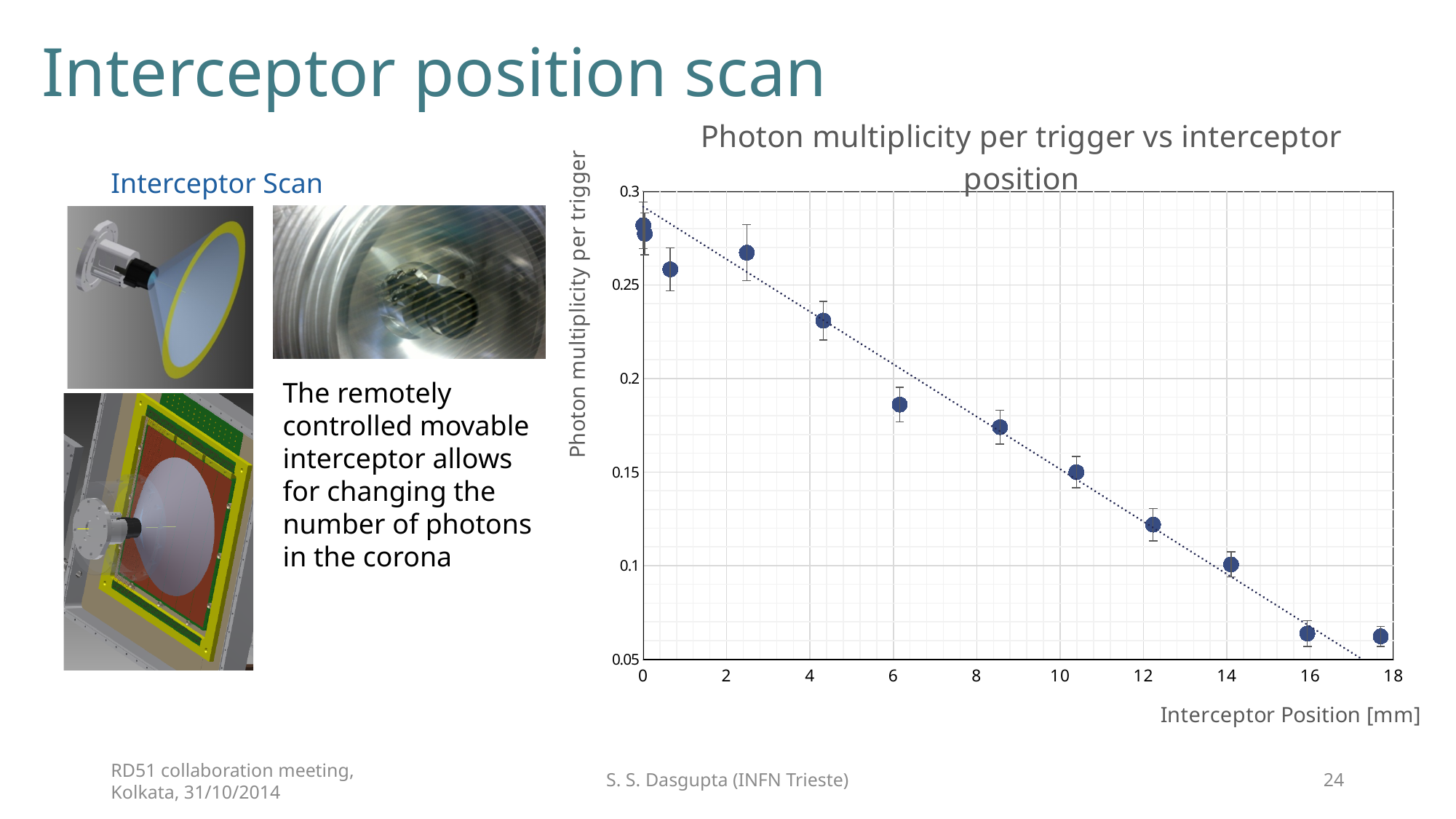
What is the title of the chart? Photon multiplicity per trigger vs interceptor position What kind of chart is shown on the slide? scatter plot Does the photon multiplicity per trigger rise or fall as the interceptor position increases? fall Is the photon multiplicity per trigger at an interceptor position of 0 mm greater or less than 0.25? greater Is the photon multiplicity per trigger at an interceptor position of about 12 mm greater or less than 0.1? greater Is the photon multiplicity per trigger at an interceptor position of about 16 mm greater or less than 0.1? less At roughly which interceptor position is the photon multiplicity per trigger highest? 0 mm Which has the higher photon multiplicity per trigger: the point at about 4 mm or the point at about 16 mm? the point at about 4 mm What is the label of the x axis of the chart? Interceptor Position [mm]